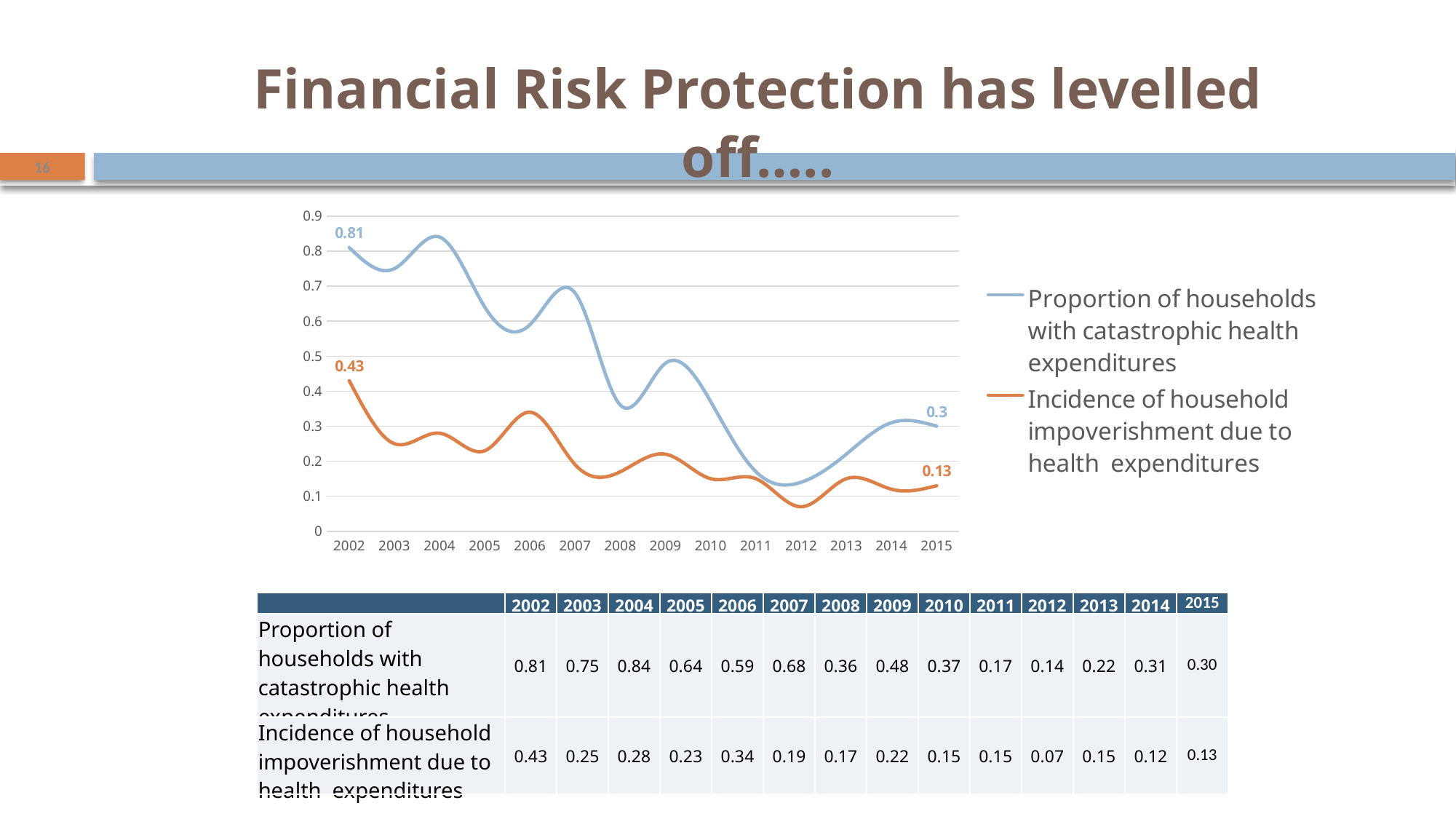
What is the difference between the 2002 and 2015 values for Proportion of households with catastrophic health expenditures? 0.51 What is the labelled value for Incidence of household impoverishment due to health expenditures in 2002? 0.43 What is the labelled value for Proportion of households with catastrophic health expenditures in 2015? 0.3 What is the labelled value for Proportion of households with catastrophic health expenditures in 2002? 0.81 Is the value for Proportion of households with catastrophic health expenditures in 2004 greater or less than 0.8? greater How many series does the chart legend list? 2 How many years are plotted along the x axis of the chart? 14 What colour is the line for Incidence of household impoverishment due to health expenditures? orange What is the labelled value for Incidence of household impoverishment due to health expenditures in 2015? 0.13 What type of chart is shown on the slide? line chart Which series has the higher value in 2002, Proportion of households with catastrophic health expenditures or Incidence of household impoverishment due to health expenditures? Proportion of households with catastrophic health expenditures Overall, do the values for Proportion of households with catastrophic health expenditures rise or fall from 2002 to 2015? fall